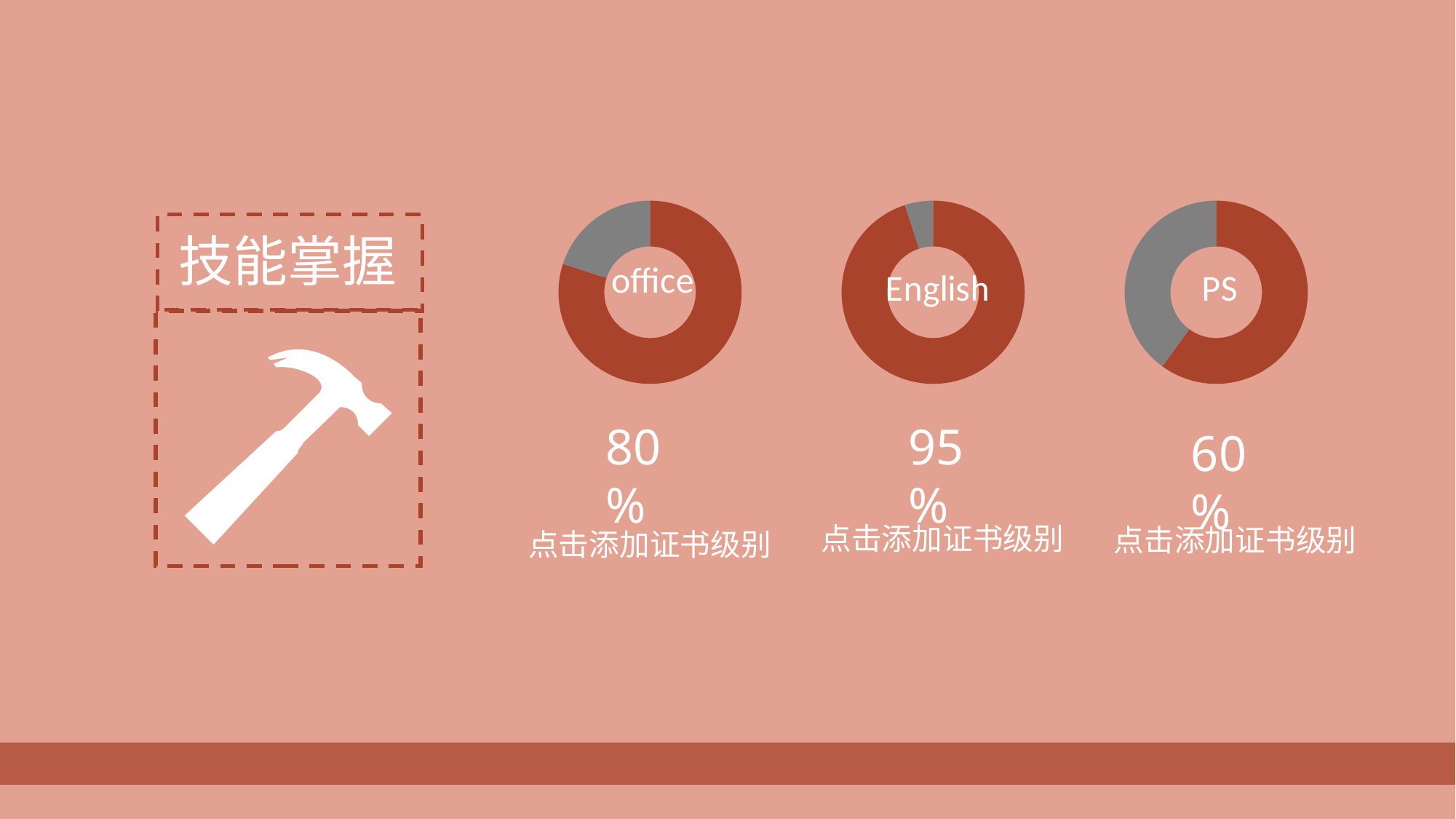
What percentage is shown for the PS donut chart? 60% Which of the three skills has the highest percentage? English What percentage is shown for the office donut chart? 80% What percentage is shown for the English donut chart? 95% How many donut charts are shown on the slide? 3 What is the difference between the English percentage and the PS percentage? 35% What is the title of the slide? 技能掌握 What is the difference between the office percentage and the PS percentage? 20% Which of the three skills has the lowest percentage? PS Which is larger, the office percentage or the English percentage? English What label appears in the centre of the rightmost donut chart? PS What kind of chart is used to show each skill level? Donut chart